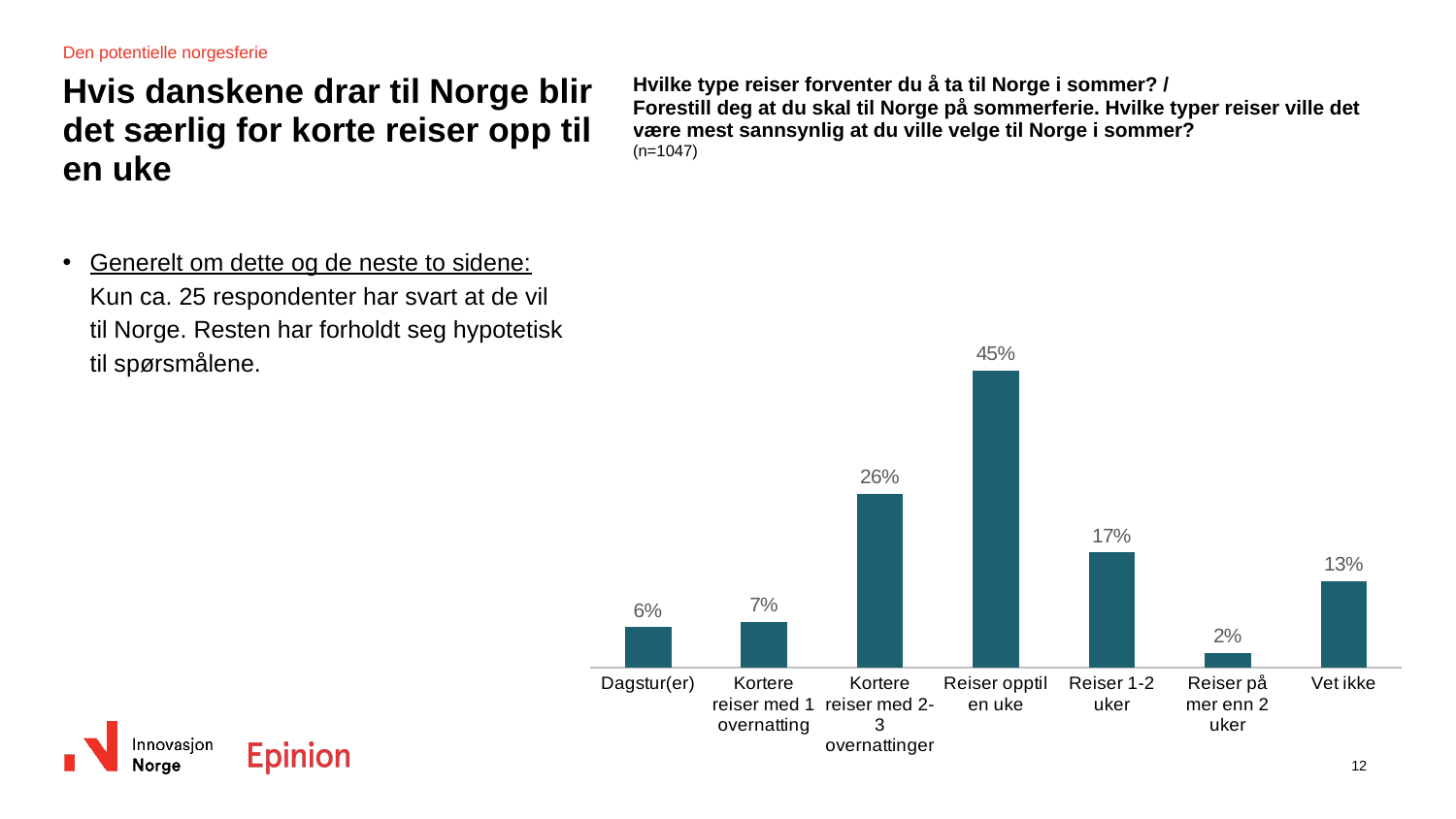
Which category has the highest value? Reiser opptil en uke What is the value for "Reiser opptil en uke"? 45% Which category has the lowest value? Reiser på mer enn 2 uker What is the value for "Kortere reiser med 2-3 overnattinger"? 26% What is the value for "Dagstur(er)"? 6% What is the difference between the values for "Reiser opptil en uke" and "Reiser 1-2 uker"? 28% What kind of chart is shown on the slide? Bar chart How many categories are shown in the chart? 7 What is the sample size (n) stated above the chart? n=1047 Which is larger, the value for "Kortere reiser med 1 overnatting" or the value for "Vet ikke"? Vet ikke What is the difference between the values for "Kortere reiser med 2-3 overnattinger" and "Kortere reiser med 1 overnatting"? 19% What is the value for "Vet ikke"? 13%